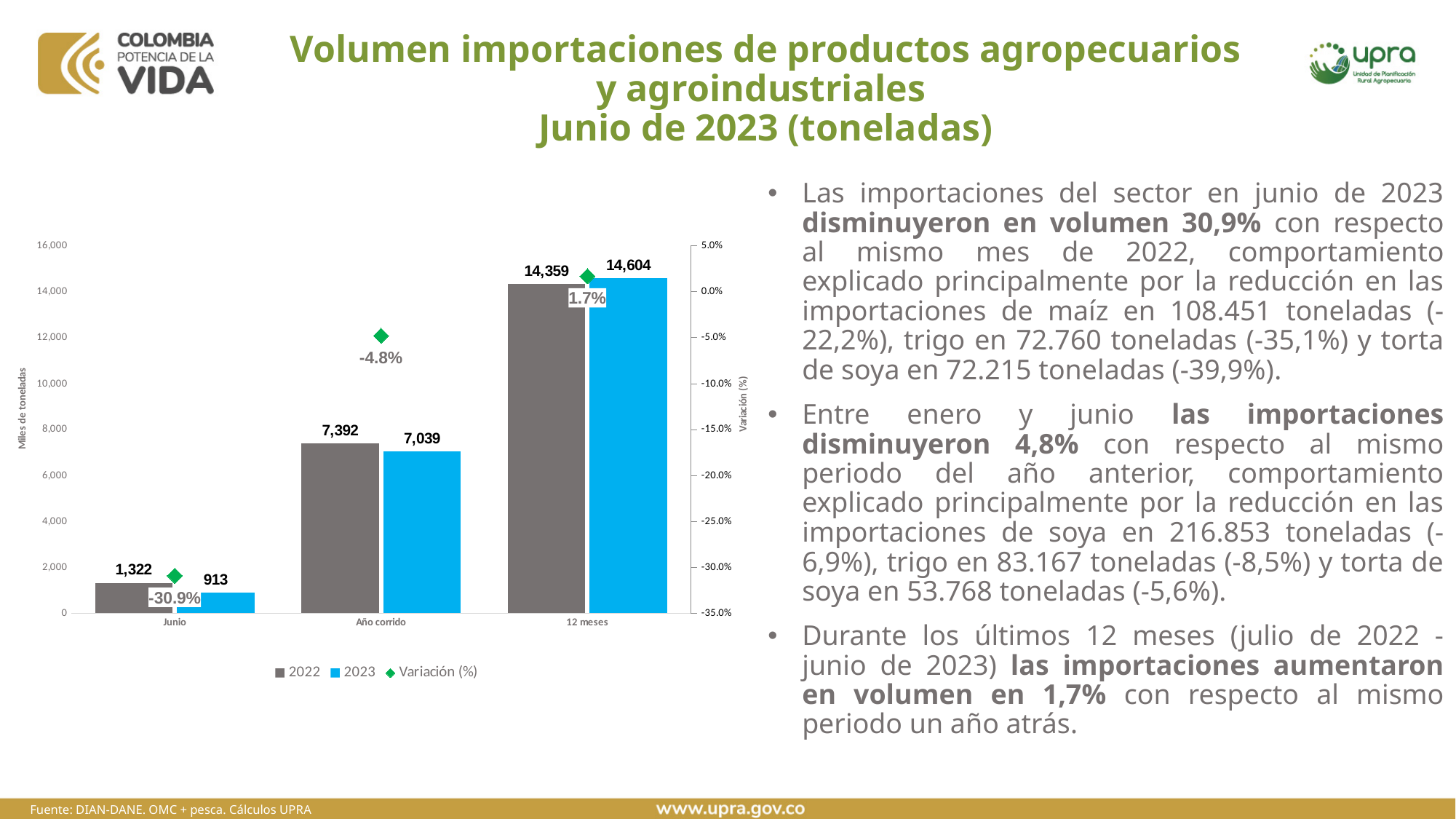
How many series does the legend list? 3 What is the Variación (%) value for Junio? -30.9% Which category has the highest 2023 value? 12 meses What is the 2023 value for Año corrido? 7,039 Which category has the lowest 2022 value? Junio How many categories are shown on the x axis? 3 What is the Variación (%) value for 12 meses? 1.7% What kind of chart is shown on the slide? Bar chart with a line/marker series Which series is shown in blue? 2023 What is the 2022 value for Junio? 1,322 What is the difference between the 2022 and 2023 values for Junio? 409 Which is larger for 12 meses, the 2022 value or the 2023 value? 2023